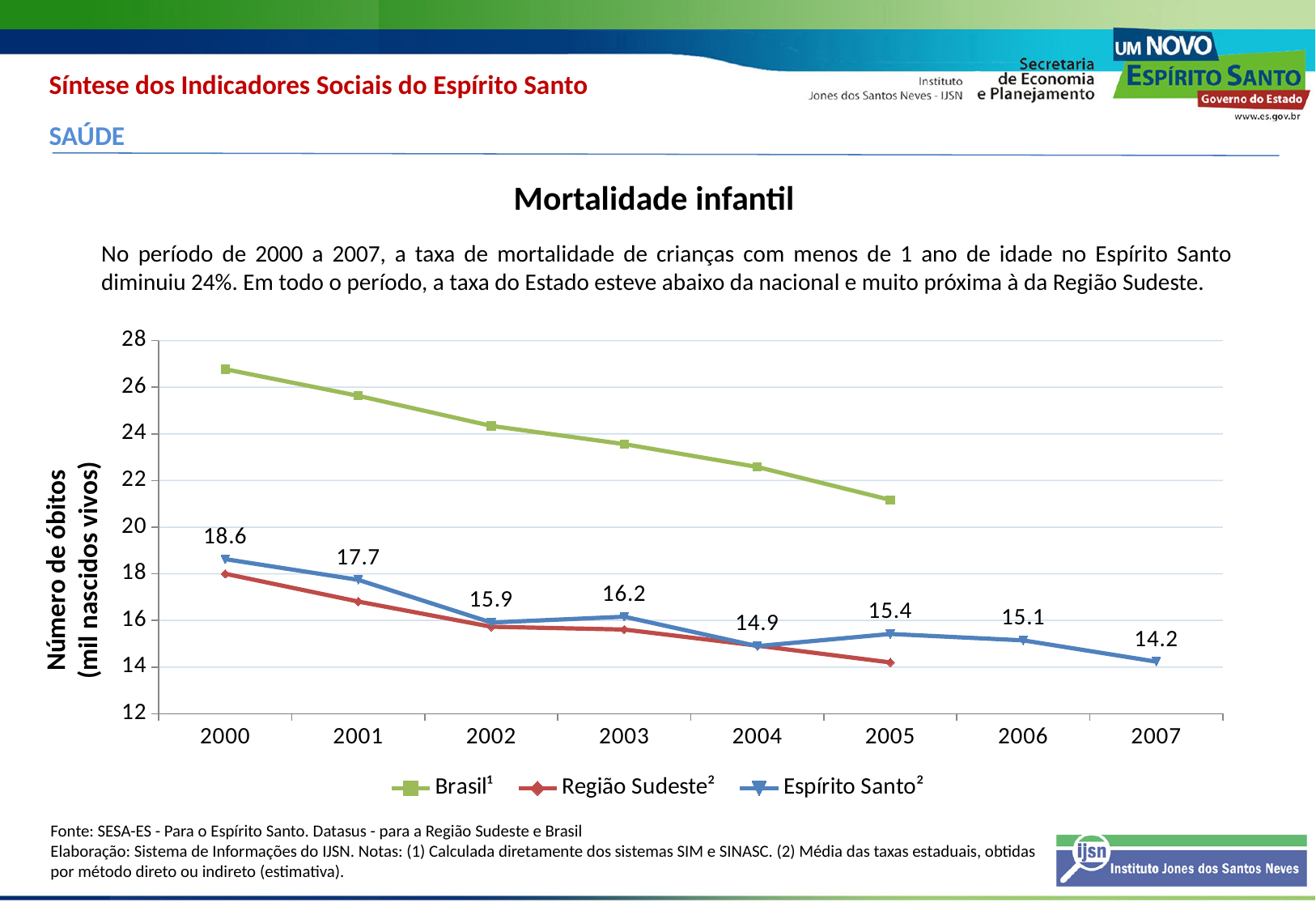
Is the value for Brasil in 2000 greater or less than 26? greater What is the value for Espírito Santo in 2000? 18.6 How many years are shown on the x axis? 8 What kind of chart is shown on the slide? Line chart Is the value for Região Sudeste in 2000 greater or less than 20? less In which year is the Espírito Santo series highest? 2000 Which series has the higher value in 2003, Brasil or Espírito Santo? Brasil How many series does the legend list? 3 What is the value for Espírito Santo in 2003? 16.2 In which year is the Espírito Santo series lowest? 2007 What is the value for Espírito Santo in 2007? 14.2 What is the difference between the Espírito Santo values for 2000 and 2007? 4.4